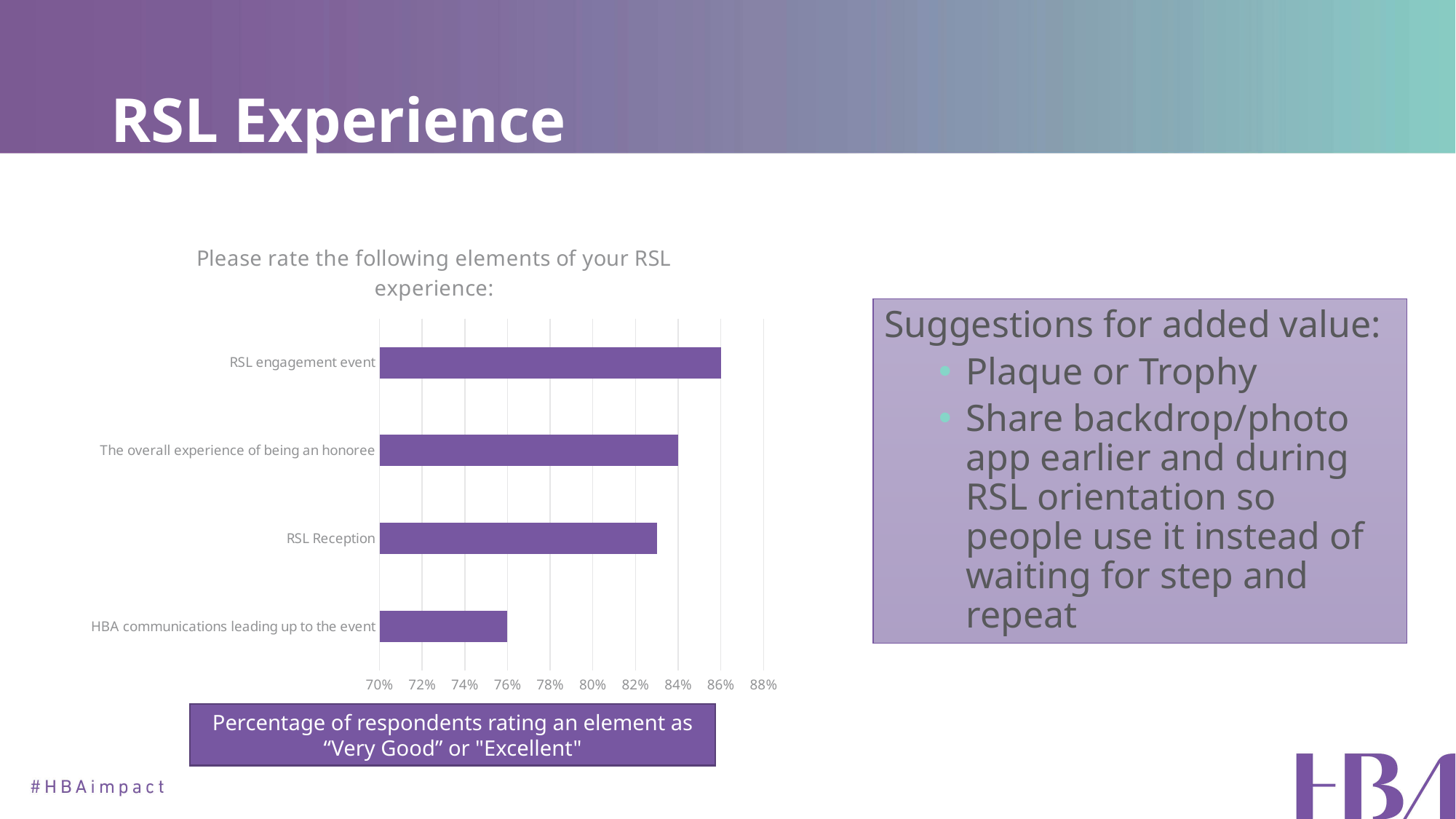
What is the title of the chart? Please rate the following elements of your RSL experience: Is the value for RSL Reception greater or less than 80%? greater Is the value for HBA communications leading up to the event greater or less than 80%? less How many elements of the RSL experience are rated in the chart? 4 Which element has the highest percentage of respondents rating it "Very Good" or "Excellent"? RSL engagement event Which element has the lowest percentage of respondents rating it "Very Good" or "Excellent"? HBA communications leading up to the event What percentage of respondents rated the overall experience of being an honoree as "Very Good" or "Excellent"? 84% What is the difference in percentage points between the RSL engagement event and HBA communications leading up to the event? 10 percentage points What percentage of respondents rated HBA communications leading up to the event as "Very Good" or "Excellent"? 76% What percentage of respondents rated the RSL engagement event as "Very Good" or "Excellent"? 86% Which is rated higher: the RSL engagement event or the RSL Reception? RSL engagement event What kind of chart is shown on the slide? Bar chart